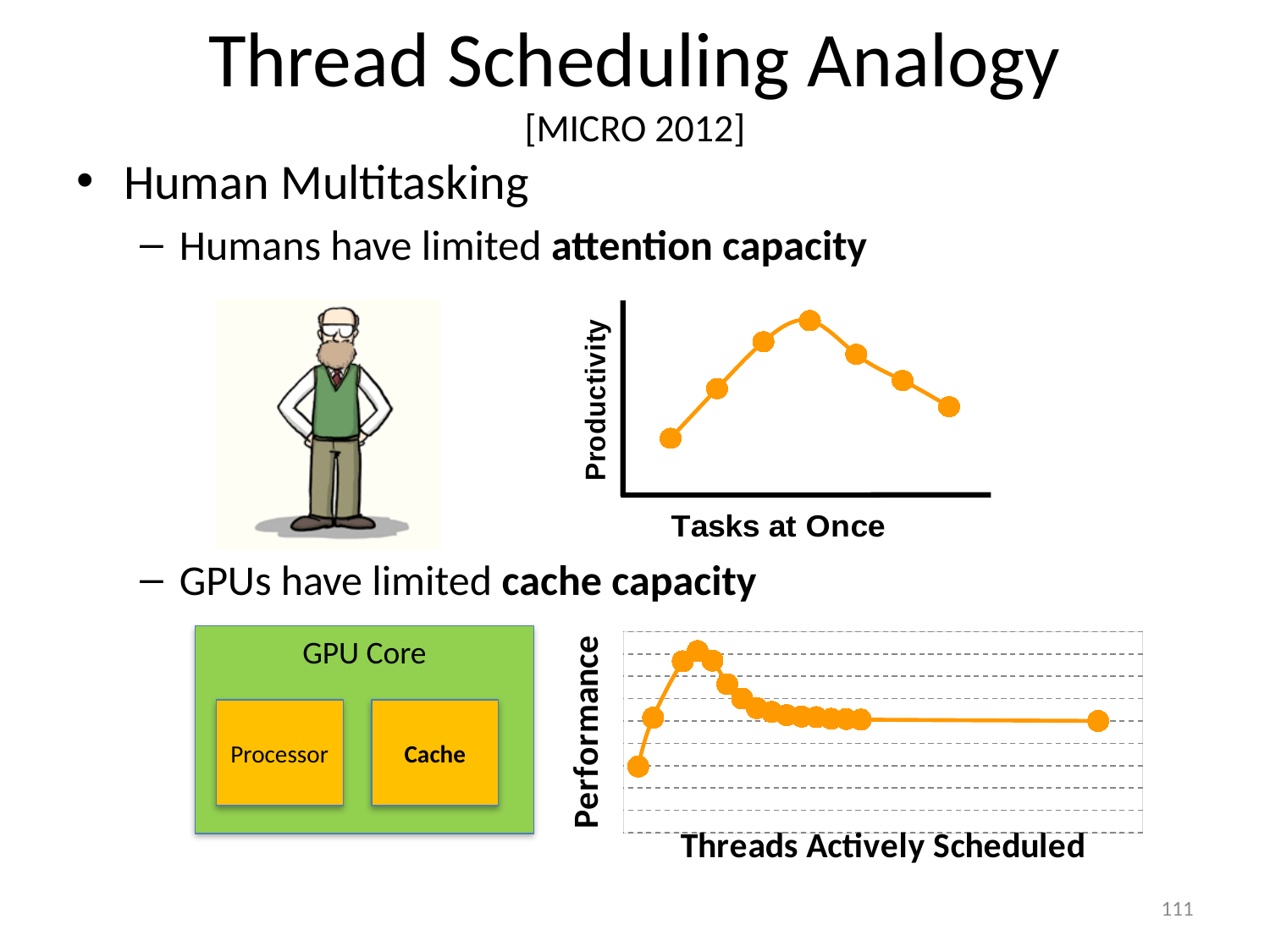
In the bottom-right chart with the y axis labelled Performance, what kind of chart is it? line chart In the top-right chart with the y axis labelled Productivity, does productivity rise or fall as tasks at once increase beyond the peak? fall In the top-right chart with the y axis labelled Productivity, what kind of chart is it? line chart In the top-right chart with the y axis labelled Productivity, does productivity rise or fall over the first four points along the x axis? rise In the top-right chart with the y axis labelled Productivity, how many data points are plotted? 7 In the bottom-right chart with the y axis labelled Performance, does performance rise or fall over the first few points along the x axis? rise In the top-right chart with the y axis labelled Productivity, is the first point or the last point higher? the last point In the bottom-right chart with the y axis labelled Performance, is the first point or the last point higher? the last point In the bottom-right chart with the y axis labelled Performance, what is the label of the x axis? Threads Actively Scheduled In the top-right chart with the y axis labelled Productivity, which point is the highest: the fourth point or the first point? the fourth point In the top-right chart with the y axis labelled Productivity, what is the label of the x axis? Tasks at Once